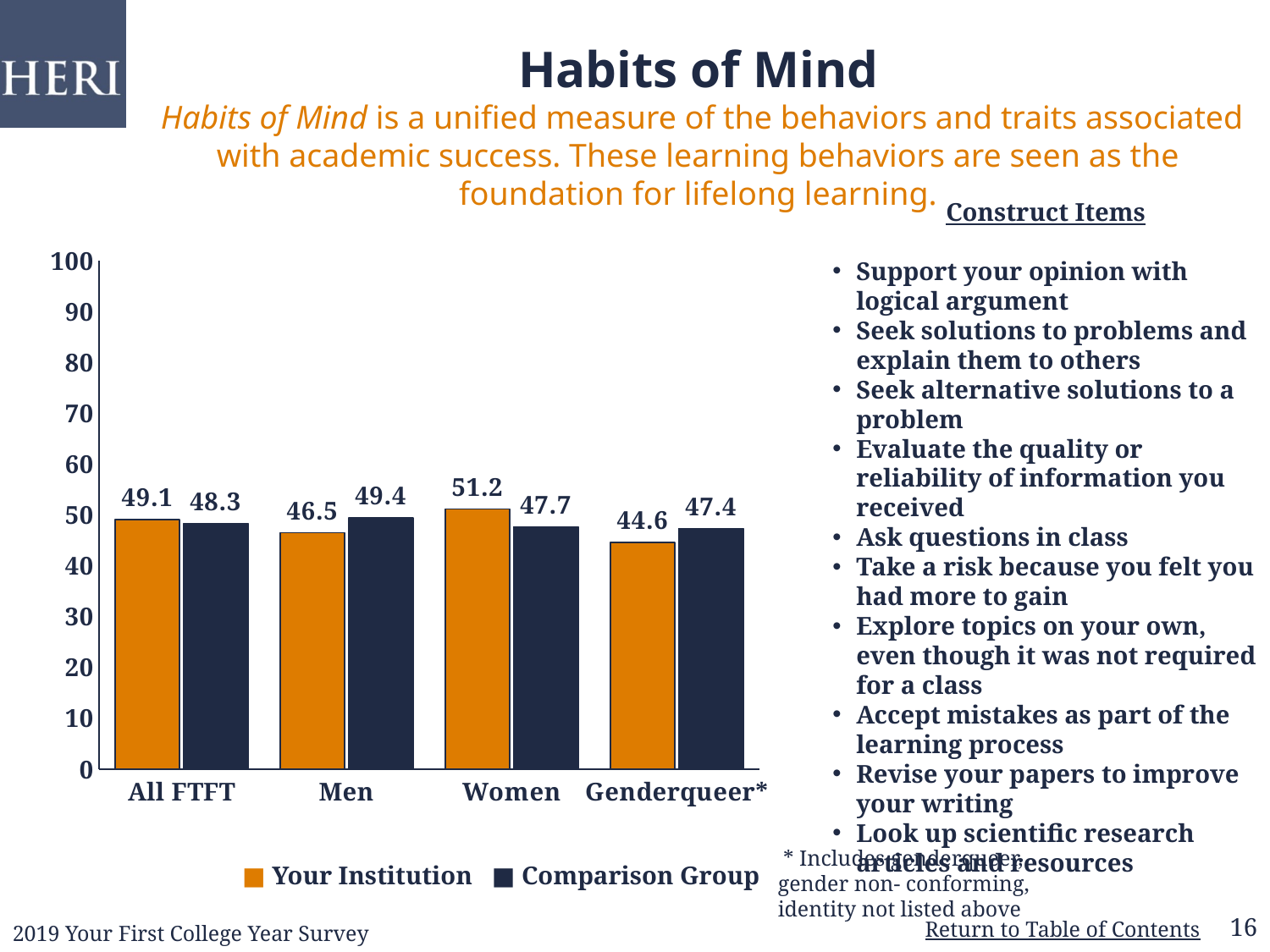
What kind of chart is shown on the slide? Bar chart What is the Comparison Group value for Men? 49.4 Which category has the lowest Your Institution value? Genderqueer* How many series does the legend list? 2 Which is larger for Men: the Your Institution value or the Comparison Group value? Comparison Group Which category has the highest Your Institution value? Women How many categories are shown on the x axis? 4 What is the Comparison Group value for All FTFT? 48.3 What is the Your Institution value for Genderqueer*? 44.6 What is the Your Institution value for Women? 51.2 What is the difference between the Your Institution and Comparison Group values for Women? 3.5 Which colour represents the Comparison Group series in the legend? Dark navy blue